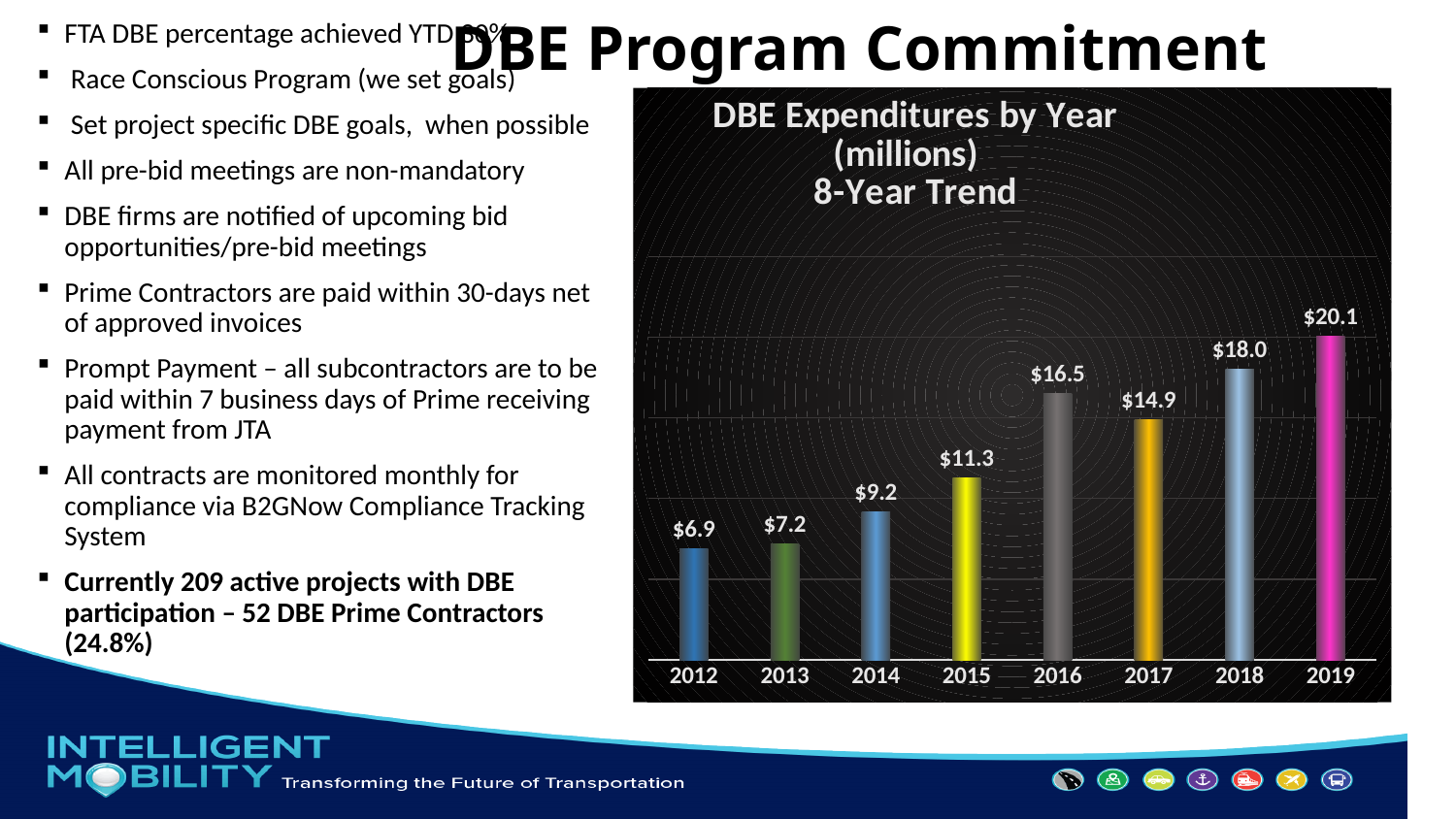
What is the DBE expenditure value shown for 2016? $16.5 What is the DBE expenditure value shown for 2019? $20.1 What is the DBE expenditure value shown for 2012? $6.9 Which year has the lowest DBE expenditure? 2012 What kind of chart is used to show DBE Expenditures by Year? Bar chart Which year has the highest DBE expenditure? 2019 What is the difference between the DBE expenditure in 2015 and in 2014? $2.1 How many years are shown on the x axis of the chart? 8 Do DBE expenditures generally rise or fall from 2012 to 2019? Rise What is the title of the chart on the slide? DBE Expenditures by Year (millions) 8-Year Trend What is the difference between the DBE expenditure in 2019 and in 2018? $2.1 Which year has a larger DBE expenditure, 2016 or 2017? 2016